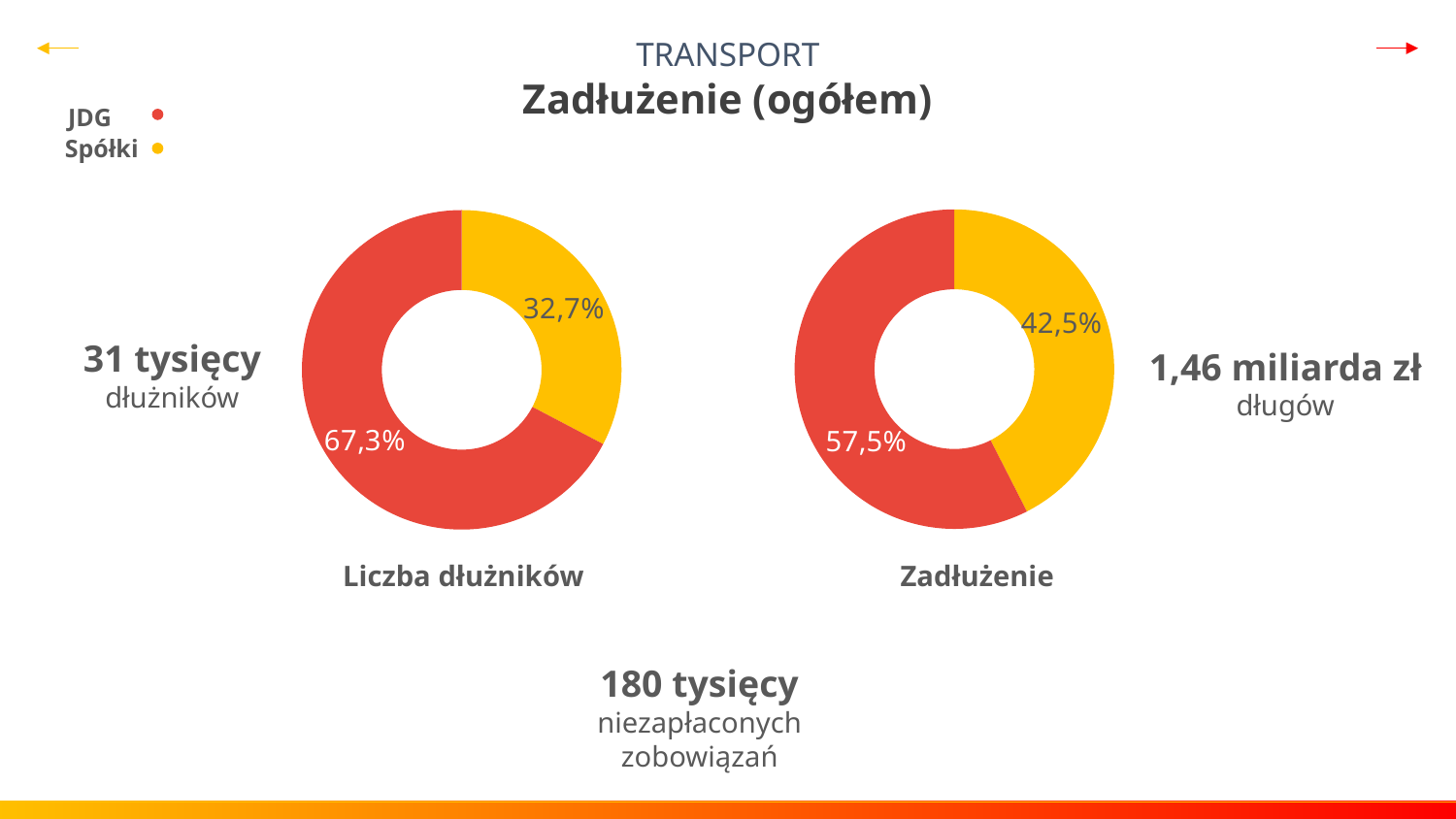
What type of chart is the "Zadłużenie" chart? Donut (pie) chart In the "Liczba dłużników" chart, what share is shown for Spółki? 32,7% In the "Liczba dłużników" chart, what is the difference in percentage points between JDG and Spółki? 34,6 In the "Liczba dłużników" chart, which category has the largest share? JDG In the "Liczba dłużników" chart, what share is shown for JDG? 67,3% Which colour represents JDG in the charts? Red In the "Zadłużenie" chart, what share is shown for JDG? 57,5% How many categories does each donut chart on the slide show? 2 In the "Zadłużenie" chart, what share is shown for Spółki? 42,5% In the "Zadłużenie" chart, which category has the smallest share? Spółki Is the share of Spółki larger in the "Liczba dłużników" chart or in the "Zadłużenie" chart? Zadłużenie In the "Zadłużenie" chart, what is the difference in percentage points between JDG and Spółki? 15